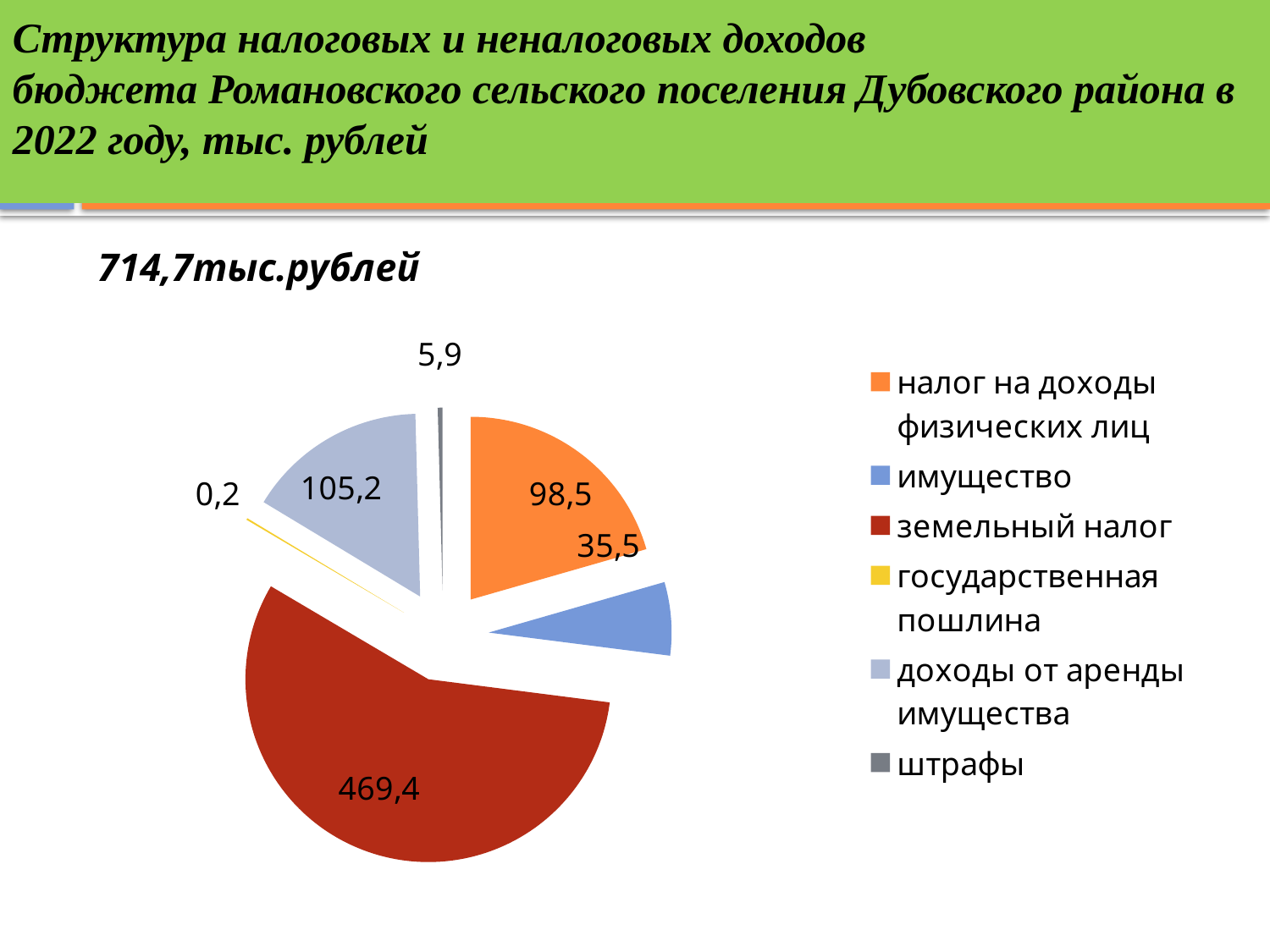
What is the value for имущество? 35,5 What total amount in thousand rubles is stated above the chart? 714,7тыс.рублей Which category has the largest slice of the pie? земельный налог What is the value for штрафы? 5,9 Which category has the smallest slice of the pie? государственная пошлина What is the value for налог на доходы физических лиц? 98,5 What is the difference between земельный налог and доходы от аренды имущества? 364,2 How many categories does the legend list? 6 What is the value for земельный налог? 469,4 What is the value for доходы от аренды имущества? 105,2 What type of chart is shown on the slide? pie chart Which is larger, доходы от аренды имущества or налог на доходы физических лиц? доходы от аренды имущества